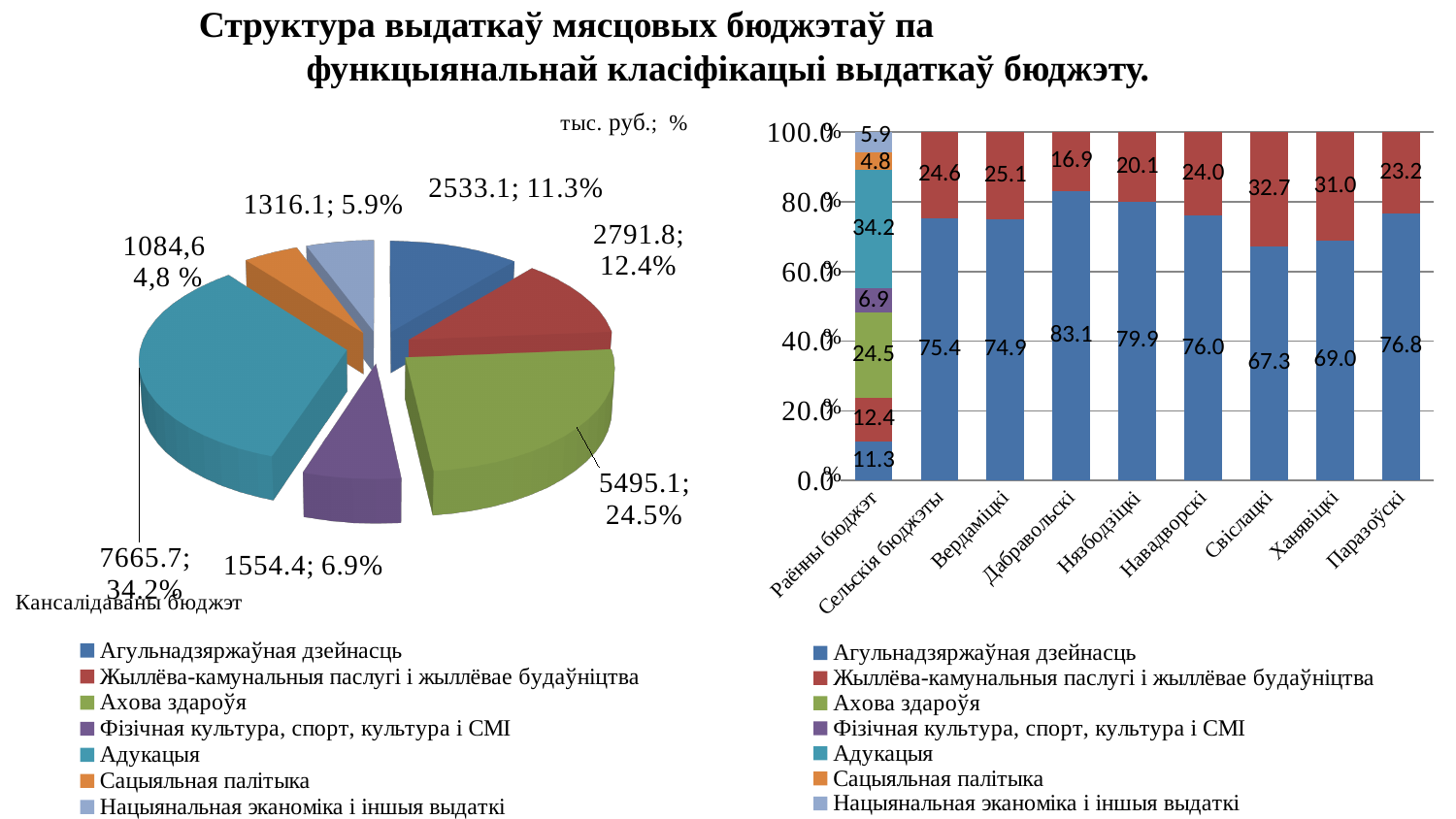
How many series does the legend of the bar chart on the right list? 7 In the bar chart on the right, which has the larger value for Жыллёва-камунальныя паслугі і жыллёвае будаўніцтва: Вердаміцкі or Паразоўскі? Вердаміцкі In the bar chart on the right, what is the difference between the Жыллёва-камунальныя паслугі і жыллёвае будаўніцтва values for Свіслацкі and Ханявіцкі? 1.7 In the bar chart on the right, what is the value of Агульнадзяржаўная дзейнасць for Дабравольскі? 83.1 In the pie chart on the left, what share of the pie does Ахова здароўя take? 24.5% In the pie chart on the left, which category has the smallest slice? Сацыяльная палітыка How many categories are shown on the x axis of the bar chart on the right? 9 In the bar chart on the right, which category has the lowest value for Агульнадзяржаўная дзейнасць? Раённы бюджэт In the pie chart on the left, what value is shown for the Адукацыя slice? 7665.7; 34.2% In the bar chart on the right, which category has the highest value for Агульнадзяржаўная дзейнасць? Дабравольскі In the pie chart on the left, which category has the largest slice? Адукацыя What kind of chart is the chart on the left of the slide? Pie chart